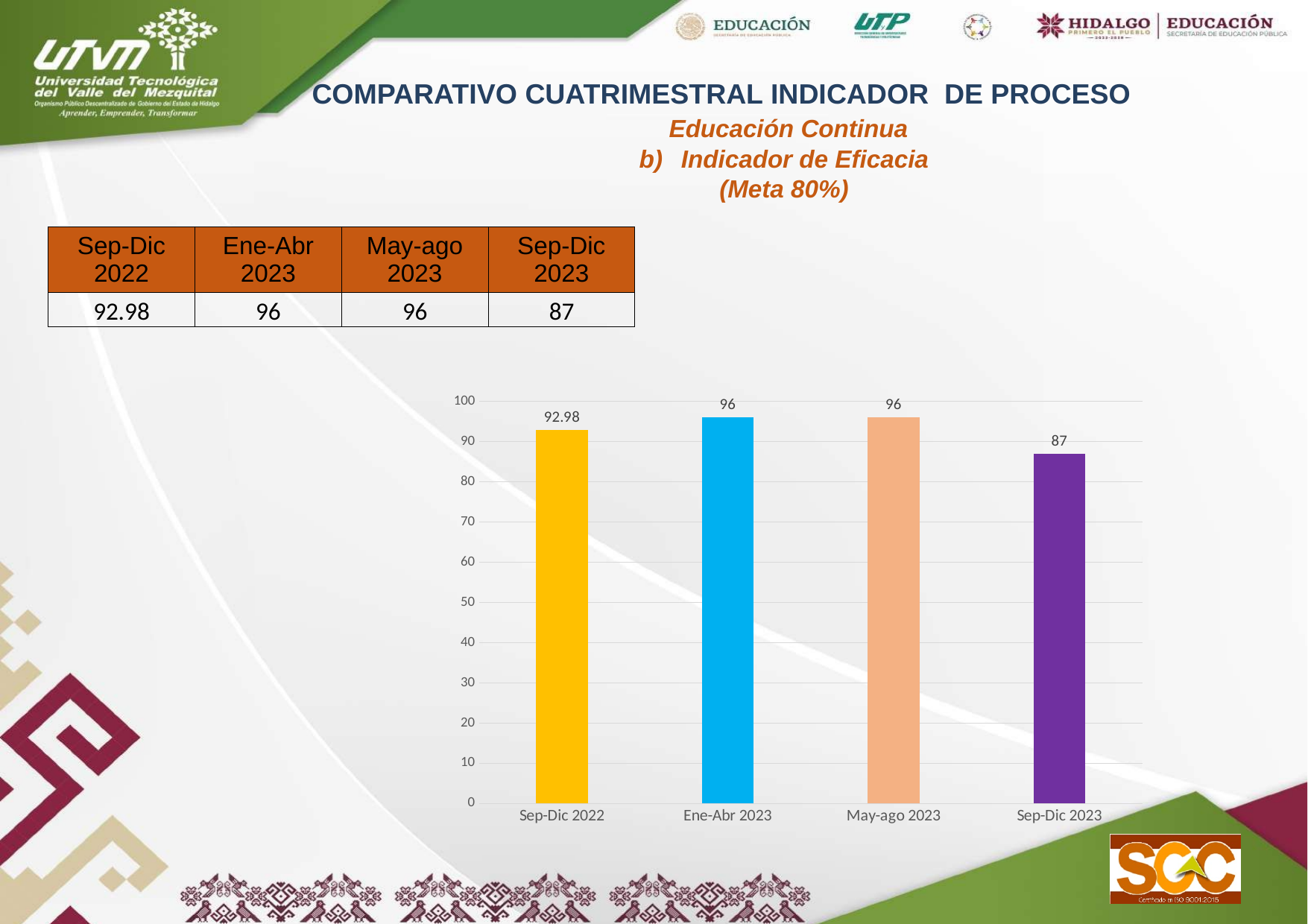
What is the value for Sep-Dic 2022? 92.98 What is the value for Sep-Dic 2023? 87 Is the value for Sep-Dic 2023 greater or less than 80? greater Which is larger, the value for Sep-Dic 2022 or the value for Sep-Dic 2023? Sep-Dic 2022 What is the value for Ene-Abr 2023? 96 What kind of chart is shown on the slide? bar chart Which period has the lowest value? Sep-Dic 2023 What is the difference between the values for Ene-Abr 2023 and Sep-Dic 2023? 9 What is the difference between the values for May-ago 2023 and Sep-Dic 2022? 3.02 Does the value rise or fall from May-ago 2023 to Sep-Dic 2023? fall What colour is the bar for Ene-Abr 2023? blue How many periods are shown on the x axis of the chart? 4